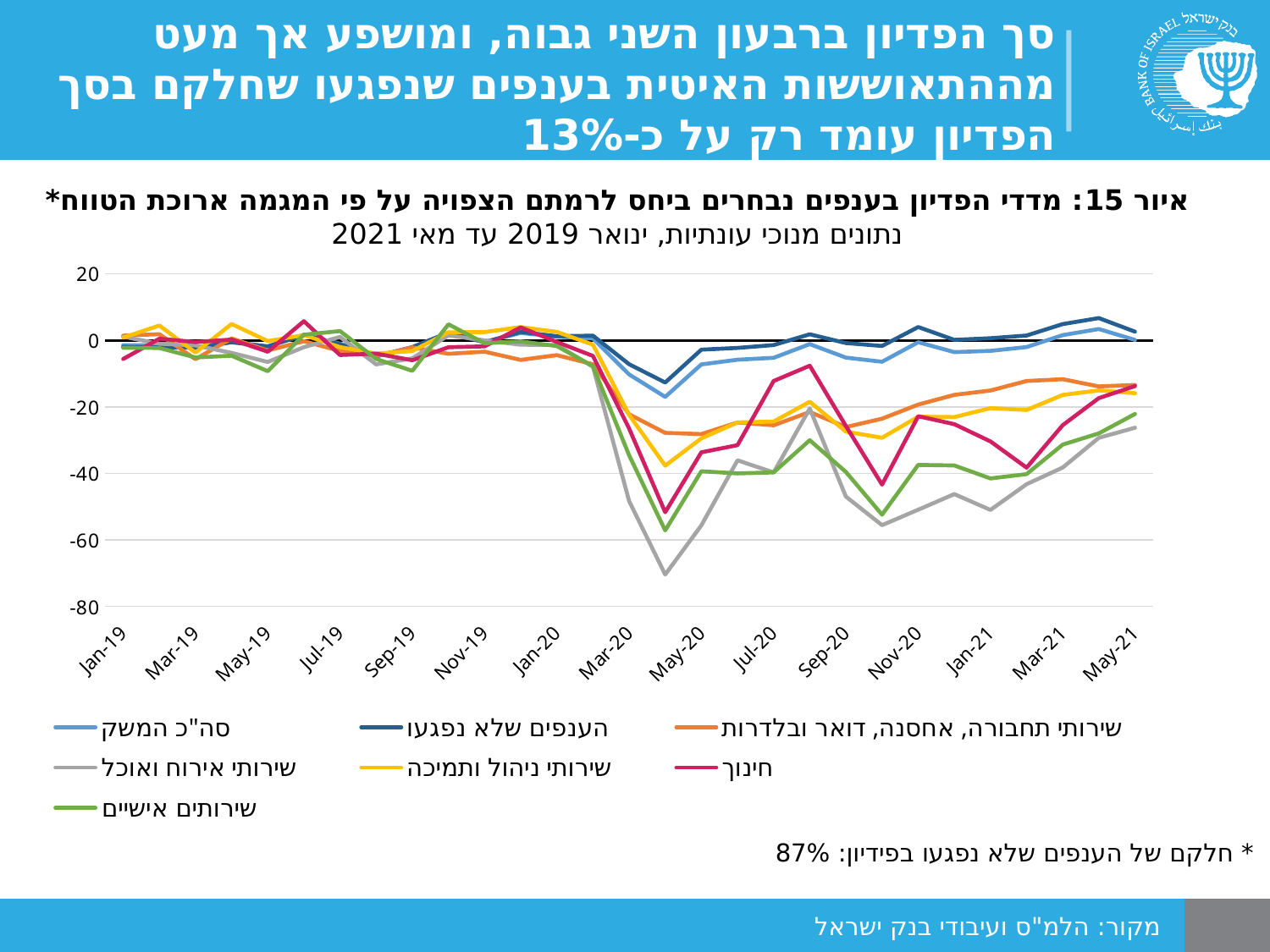
In Apr-20, which is lower: חינוך or שירותי אירוח ואוכל? שירותי אירוח ואוכל Which series has the lowest value in Apr-20? שירותי אירוח ואוכל Is the value for שירותי אירוח ואוכל in Apr-20 greater or less than -60? less How many series does the legend list? 7 According to the footnote, what is the share of the unaffected industries in total revenue? 87% Is the value for שירותי אירוח ואוכל in Nov-20 greater or less than -40? less Is the value for הענפים שלא נפגעו in Apr-20 greater or less than -20? greater Does the line for שירותי אירוח ואוכל rise or fall from Apr-20 to May-21? rise What kind of chart is shown on the slide? line chart Which series has the highest value in May-21? הענפים שלא נפגעו What is the lowest value shown on the vertical axis? -80